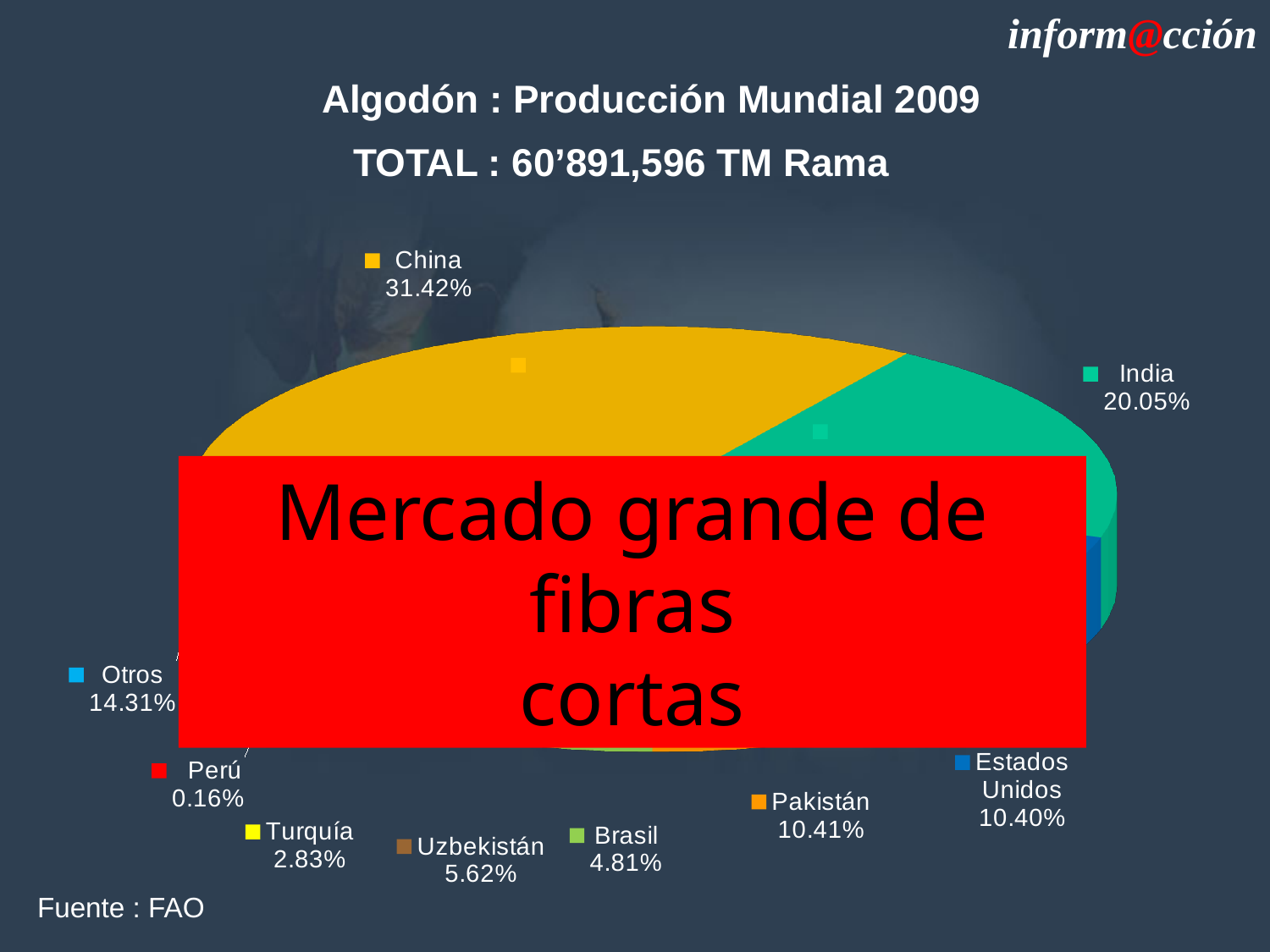
Which country has the largest share of the pie? China Which has a larger share, Brasil or Uzbekistán? Uzbekistán What is the difference in percentage points between China's and India's shares? 11.37% What total production is stated in the chart title? 60'891,596 TM Rama What kind of chart is shown on the slide? pie chart Which named category has the smallest share of the pie? Perú What percentage is shown for Uzbekistán? 5.62% What percentage is shown for India? 20.05% What source is cited for the chart data? FAO How many categories (slices) are labelled in the pie chart? 9 What share of world cotton production in 2009 does China hold? 31.42% What percentage is shown for Perú? 0.16%